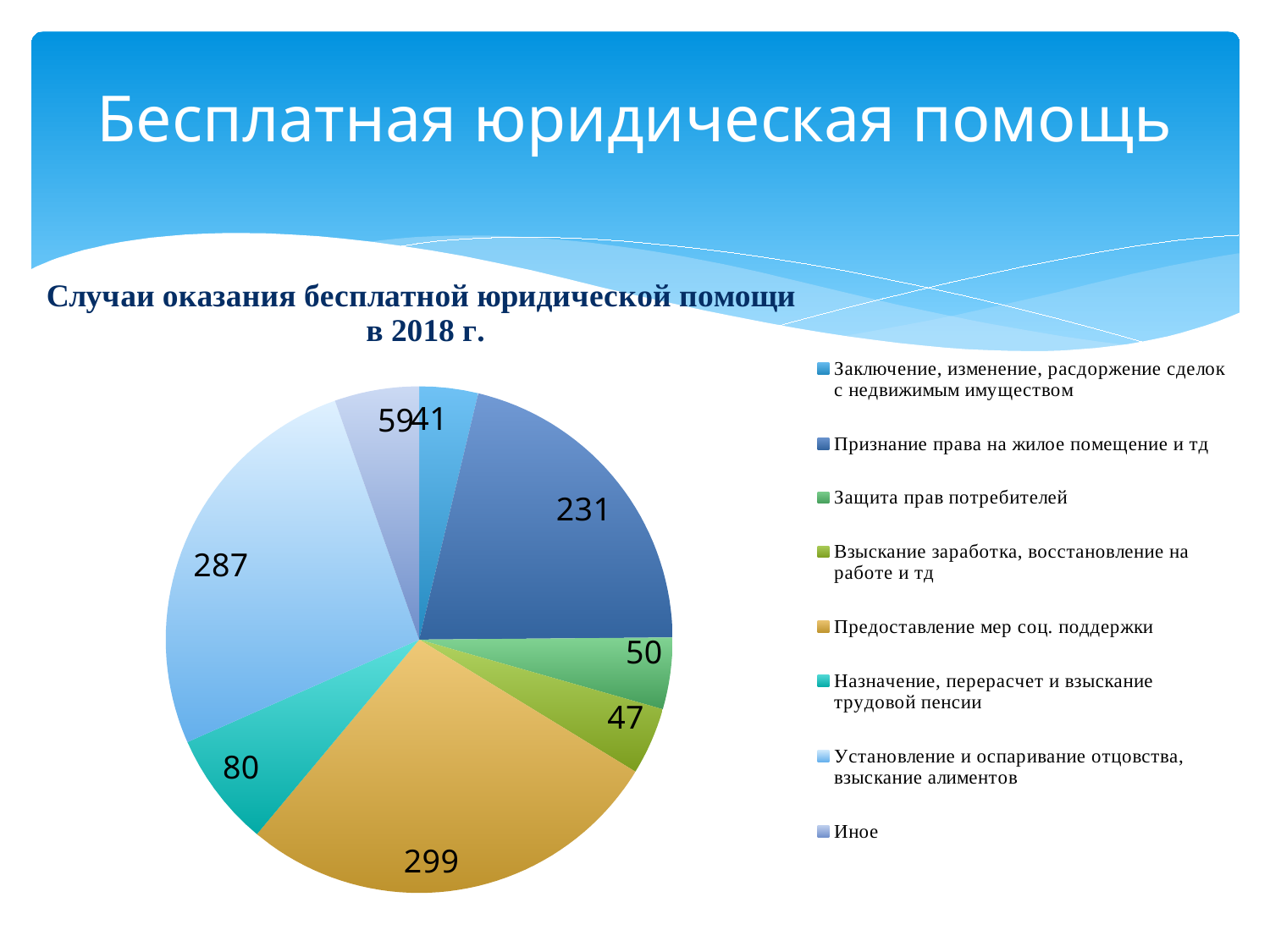
What is the value for "Иное"? 59 What is the value for "Признание права на жилое помещение и тд"? 231 Which is larger: the value for "Защита прав потребителей" or the value for "Взыскание заработка, восстановление на работе и тд"? Защита прав потребителей What is the difference between the values for "Предоставление мер соц. поддержки" and "Установление и оспаривание отцовства, взыскание алиментов"? 12 How many categories does the legend list? 8 Which category has the largest slice? Предоставление мер соц. поддержки What is the value for "Предоставление мер соц. поддержки"? 299 What kind of chart is shown on the slide? pie chart How many slices does the pie chart have? 8 What is the title of the chart? Случаи оказания бесплатной юридической помощи в 2018 г. What is the value for "Назначение, перерасчет и взыскание трудовой пенсии"? 80 Which category has the smallest slice? Заключение, изменение, расдоржение сделок с недвижимым имуществом